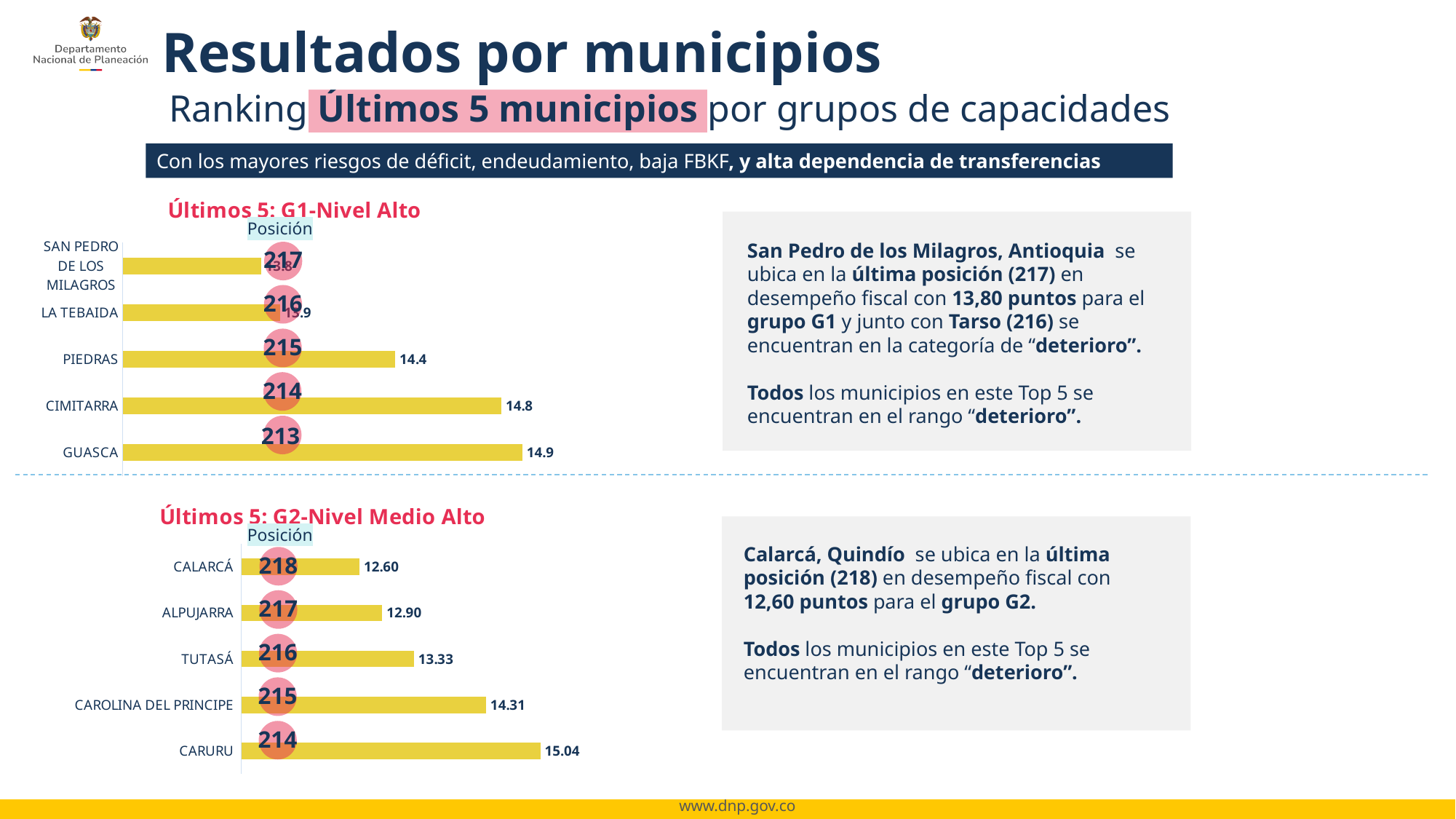
In the 'Últimos 5: G2-Nivel Medio Alto' chart, what is the difference between the values for CARURU and CAROLINA DEL PRINCIPE? 0.73 In the 'Últimos 5: G2-Nivel Medio Alto' chart, what is the value for TUTASÁ? 13.33 In the 'Últimos 5: G2-Nivel Medio Alto' chart, what is the value for CALARCÁ? 12.60 In the 'Últimos 5: G1-Nivel Alto' chart, what is the difference between the values for GUASCA and CIMITARRA? 0.1 In the 'Últimos 5: G1-Nivel Alto' chart, which municipality has the highest value? GUASCA In the 'Últimos 5: G1-Nivel Alto' chart, how many municipalities are shown? 5 What kind of chart is the 'Últimos 5: G2-Nivel Medio Alto' chart? Bar chart In the 'Últimos 5: G2-Nivel Medio Alto' chart, which municipality has the highest value? CARURU In the 'Últimos 5: G1-Nivel Alto' chart, what is the value for PIEDRAS? 14.4 In the 'Últimos 5: G1-Nivel Alto' chart, what is the value for GUASCA? 14.9 In the 'Últimos 5: G2-Nivel Medio Alto' chart, which municipality has the lowest value? CALARCÁ In the 'Últimos 5: G2-Nivel Medio Alto' chart, which is larger, the value for ALPUJARRA or the value for TUTASÁ? TUTASÁ